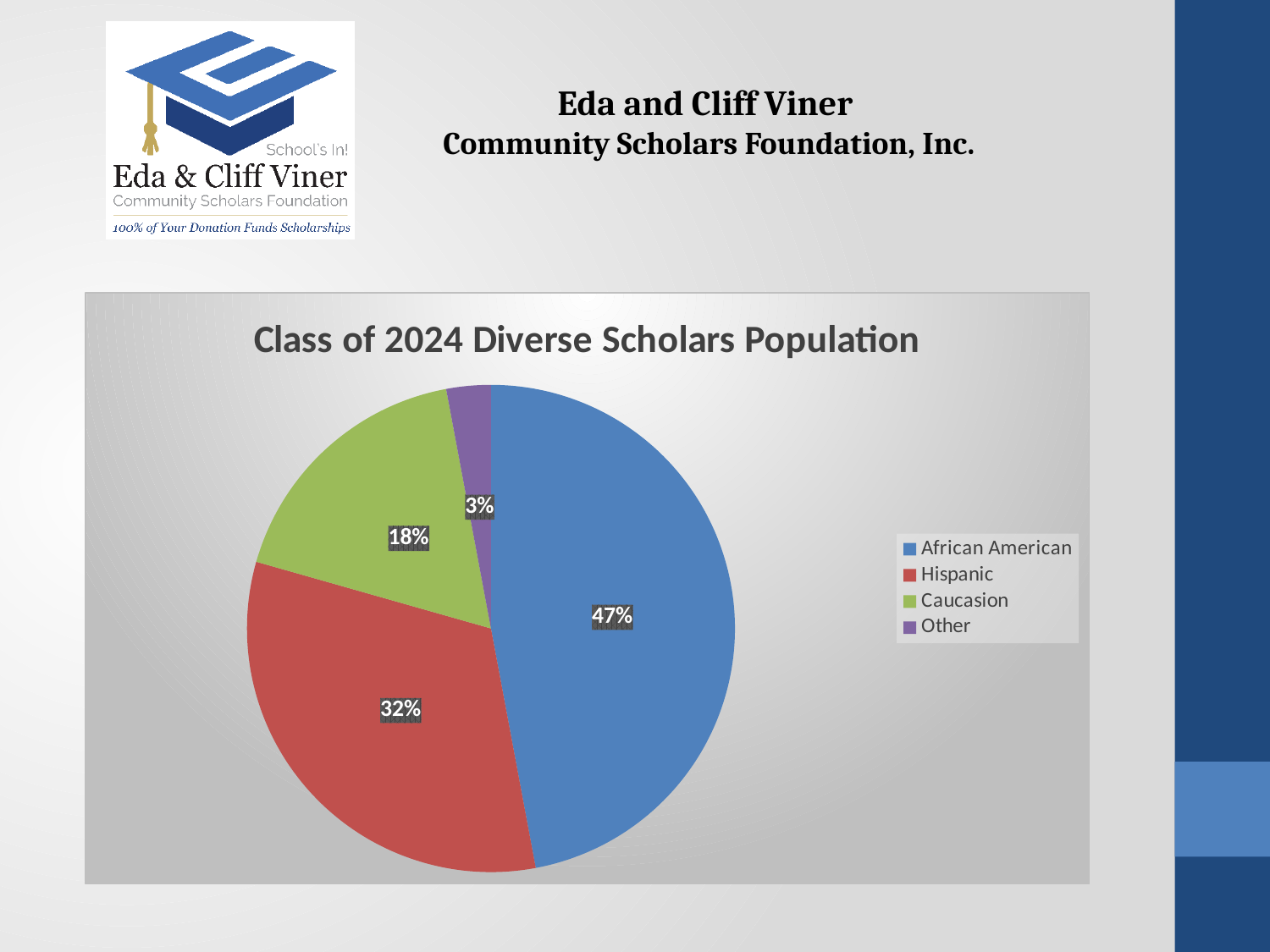
What colour is the Caucasion slice? green What share of the pie is Caucasion? 18% What share of the pie is African American? 47% Which is larger, the Hispanic slice or the Caucasion slice? Hispanic What share of the pie is Hispanic? 32% What share of the pie is Other? 3% What kind of chart is shown on the slide? pie chart How many categories does the legend list? 4 What is the title of the chart? Class of 2024 Diverse Scholars Population What is the difference in percentage points between the African American and Hispanic slices? 15 Which category has the largest slice of the pie? African American Which category has the smallest slice of the pie? Other